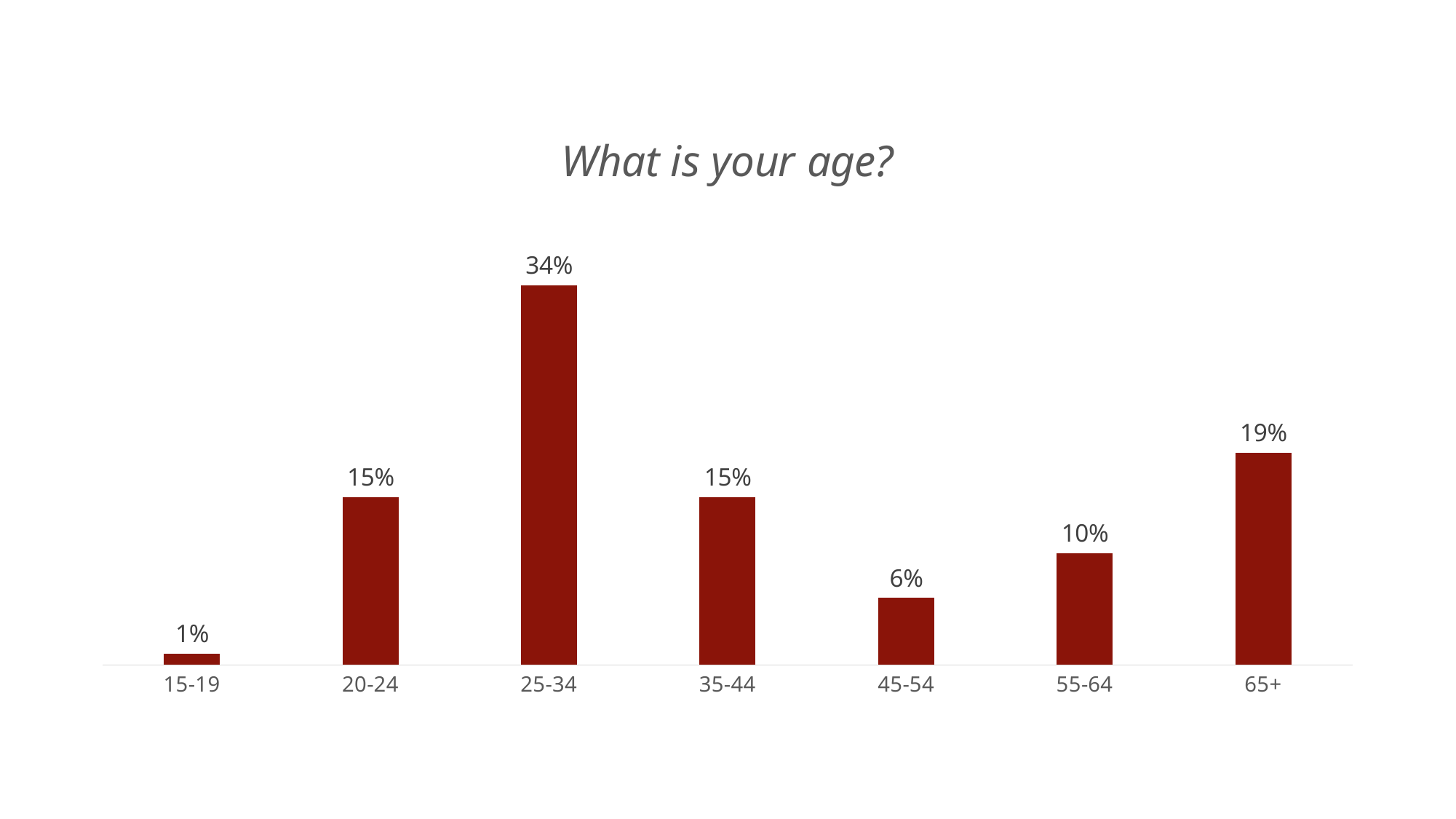
What percentage of respondents are aged 45-54? 6% Which age group has the lowest share of respondents? 15-19 Which is larger, the value for 20-24 or the value for 55-64? 20-24 Which is larger, the value for 65+ or the value for 35-44? 65+ What kind of chart is shown on the slide? Bar chart What is the difference between the values for 55-64 and 45-54? 4% What percentage of respondents are aged 25-34? 34% Which age group has the highest share of respondents? 25-34 How many age groups are shown on the chart? 7 What is the title of the chart? What is your age? What is the difference between the values for 25-34 and 65+? 15% What is the value for the 65+ age group? 19%